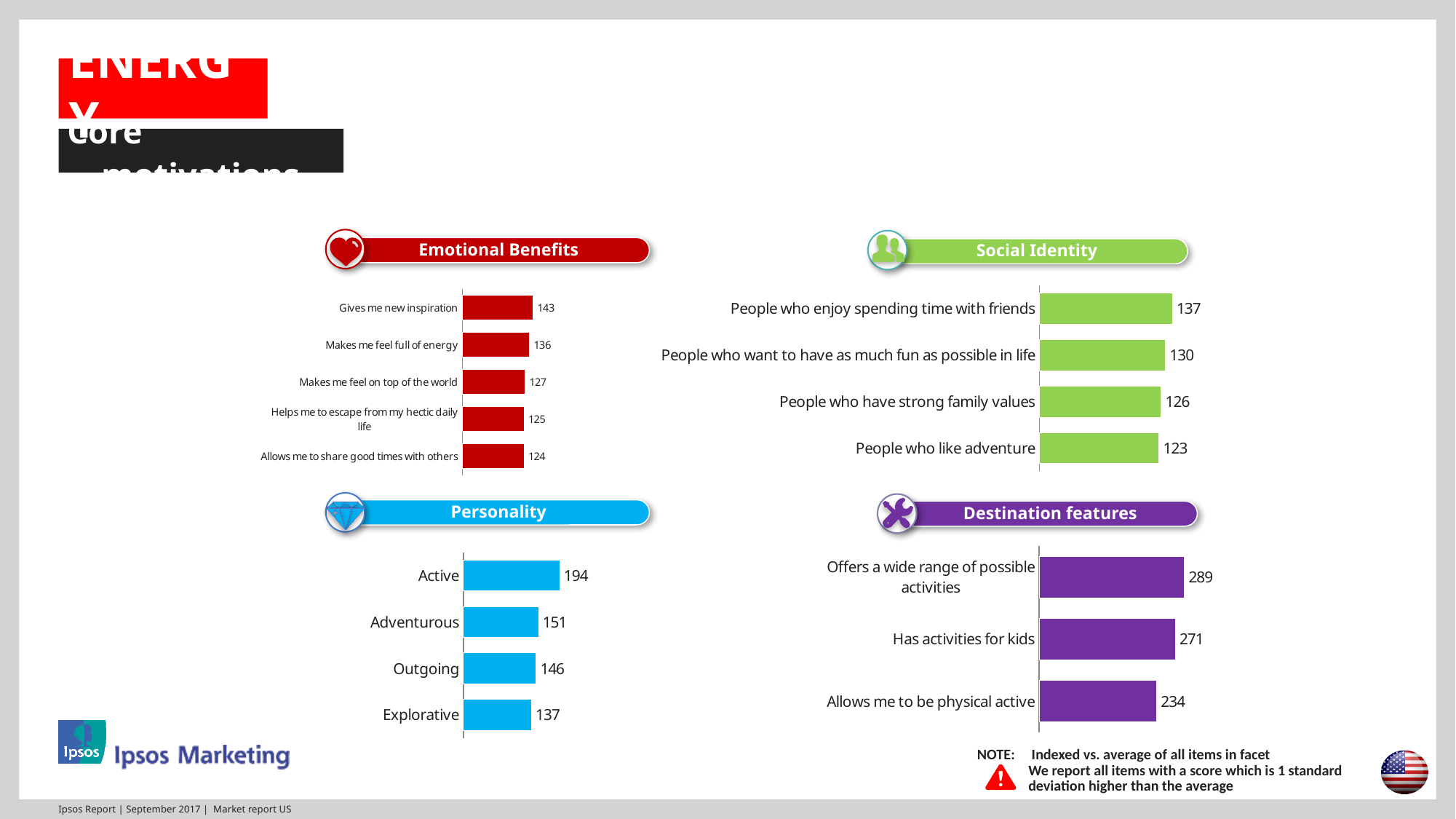
In the Personality chart, what is the value for "Outgoing"? 146 In the Destination features chart, which is larger: "Offers a wide range of possible activities" or "Allows me to be physical active"? Offers a wide range of possible activities In the Emotional Benefits chart, which category has the lowest value? Allows me to share good times with others How many categories does the Emotional Benefits chart show? 5 In the Destination features chart, what is the value for "Has activities for kids"? 271 In the Personality chart, how many categories are shown? 4 In the Social Identity chart, what is the difference between "People who enjoy spending time with friends" and "People who like adventure"? 14 In the Social Identity chart, what is the value for "People who have strong family values"? 126 In the Destination features chart, what is the difference between "Offers a wide range of possible activities" and "Has activities for kids"? 18 In the Personality chart, which category has the highest value? Active In the Emotional Benefits chart, what is the value for "Gives me new inspiration"? 143 What kind of chart is the Emotional Benefits chart? Bar chart